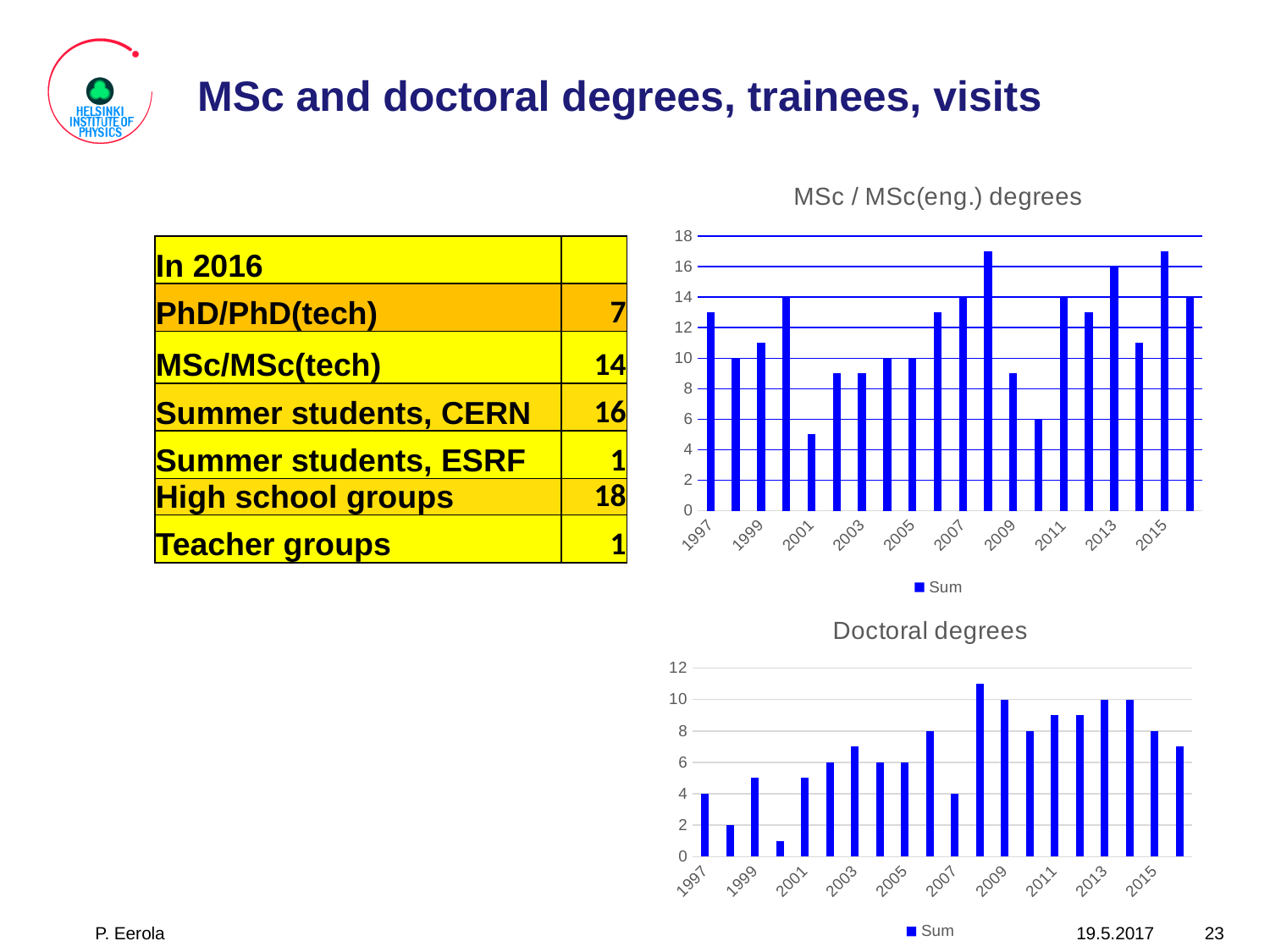
In the "Doctoral degrees" chart, is the value for 1998 greater or less than 4? less How many series does the legend of the "Doctoral degrees" chart list? 1 In the "Doctoral degrees" chart, is the value for 2008 greater or less than 10? greater In the "MSc / MSc(eng.) degrees" chart, which year has the lowest value? 2001 What kind of chart is the "MSc / MSc(eng.) degrees" chart? bar chart In the "MSc / MSc(eng.) degrees" chart, is the value for 2001 greater or less than 6? less In the "Doctoral degrees" chart, which is larger, the value for 2008 or the value for 2007? 2008 In the "MSc / MSc(eng.) degrees" chart, which is larger, the value for 2013 or the value for 2010? 2013 In the "Doctoral degrees" chart, which year has the highest value? 2008 In the "Doctoral degrees" chart, which year has the lowest value? 2000 What is the legend entry shown under the "MSc / MSc(eng.) degrees" chart? Sum